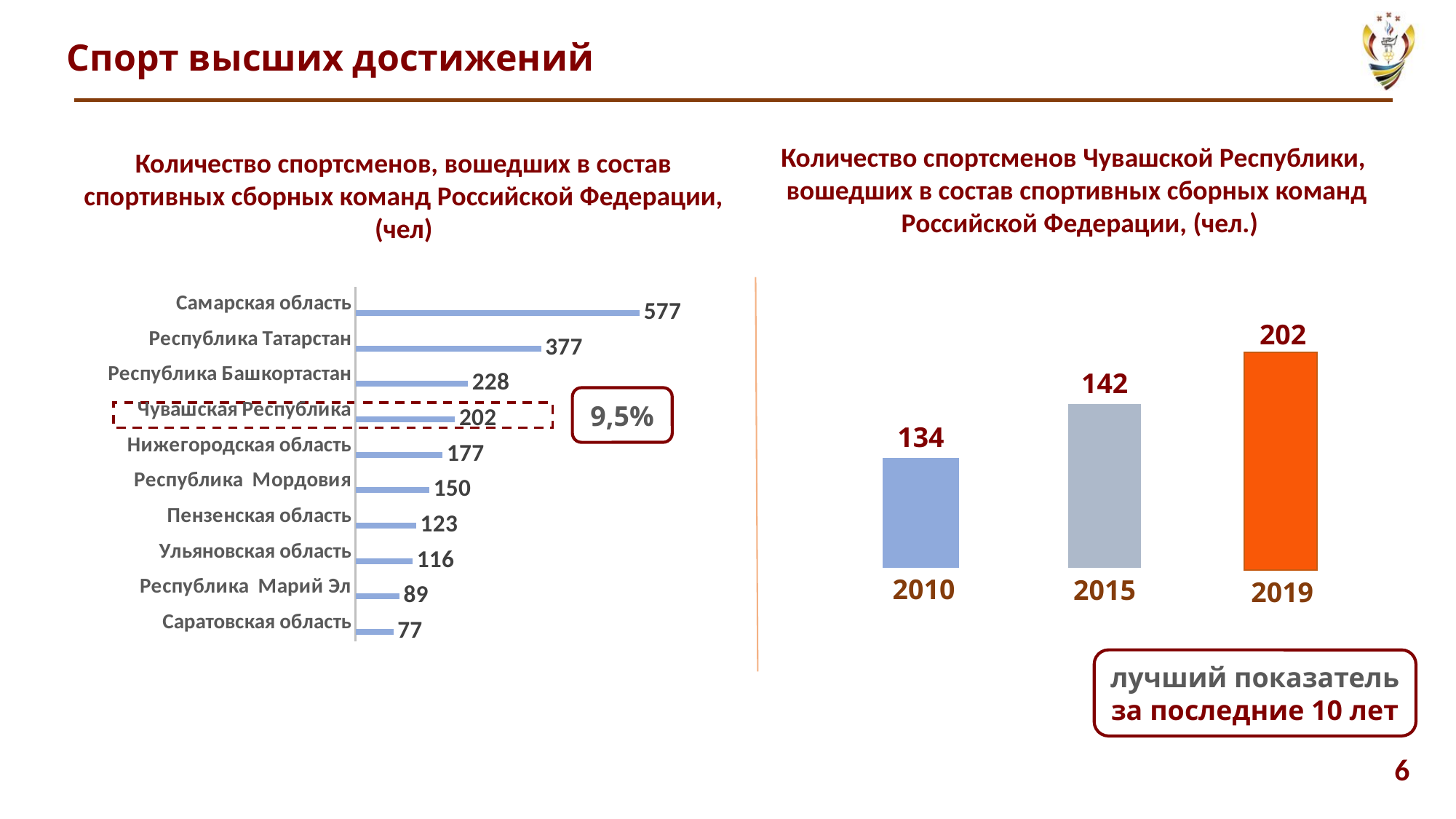
What percentage is shown in the box next to Чувашская Республика in the left chart? 9,5% In the left chart, which is larger: Пензенская область or Ульяновская область? Пензенская область What type of chart is the left chart? Bar chart In the right chart, do the values rise or fall from 2010 to 2019? Rise How many regions are shown in the left chart? 10 In the left chart, what is the value for Чувашская Республика? 202 In the left chart, which region has the highest value? Самарская область In the right chart, what is the difference between 2019 and 2010? 68 In the left chart, how many athletes does Самарская область have? 577 In the left chart, what is the difference between Республика Татарстан and Республика Башкортастан? 149 In the right chart, what is the value for 2015? 142 In the left chart, which region has the lowest value? Саратовская область